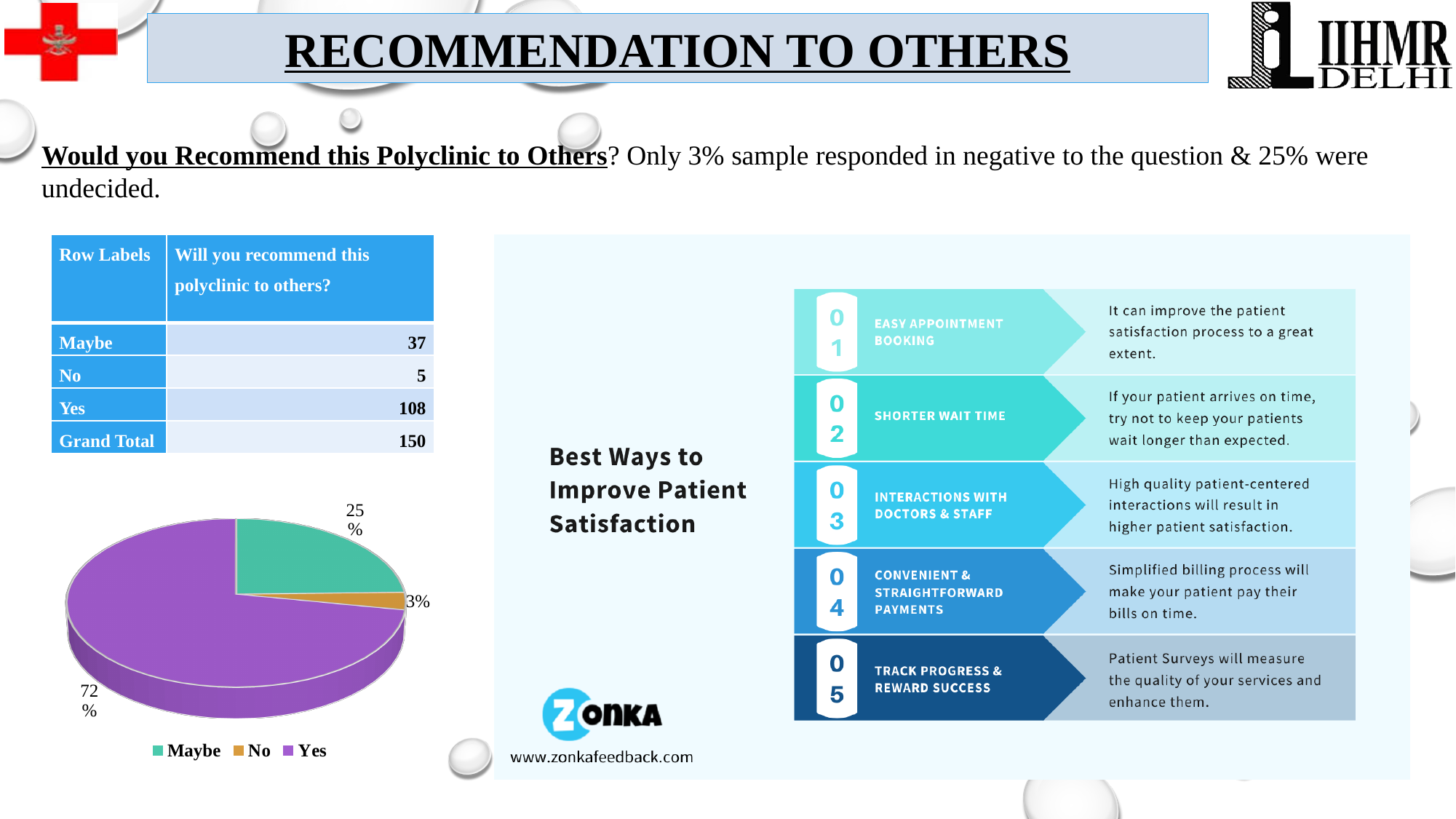
What share of the pie chart does the Yes slice represent? 72% Which category has the largest slice in the pie chart? Yes What kind of chart is shown on the slide? Pie chart What are the legend entries of the pie chart, in order? Maybe, No, Yes What share of the pie chart does the Maybe slice represent? 25% What is the difference in percentage points between the Yes slice and the Maybe slice in the pie chart? 47% Which category has the smallest slice in the pie chart? No What share of the pie chart does the No slice represent? 3% In the pie chart, which is larger, the Maybe slice or the No slice? Maybe How many slices does the pie chart have? 3 How many entries does the pie chart legend list? 3 Which colour represents the Yes slice in the pie chart? Purple